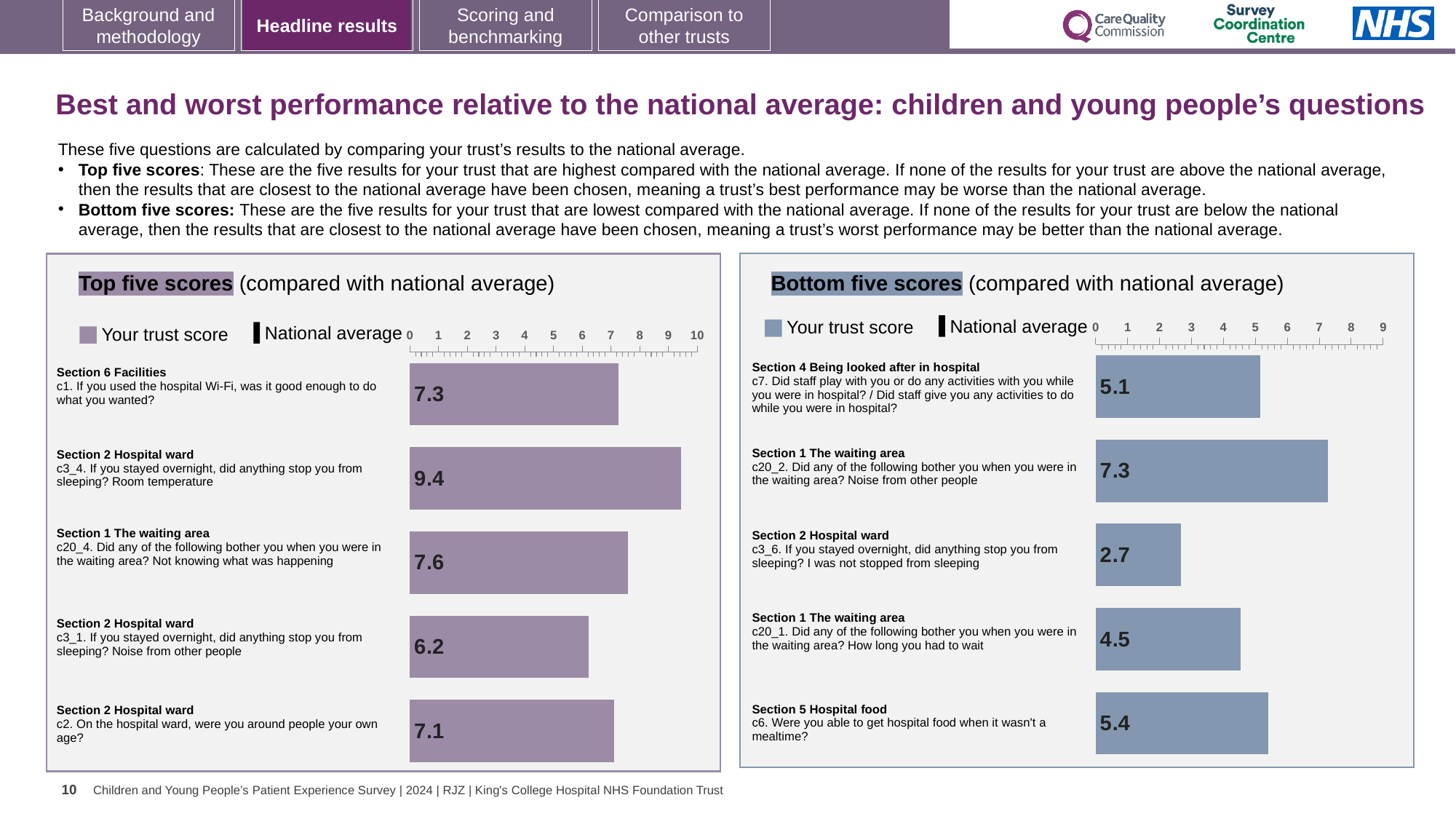
In the Top five scores chart, which question has the lowest trust score? c3_1 (Noise from other people) What type of chart is the Top five scores chart? Bar chart In the Bottom five scores chart, which question has the lowest trust score? c3_6 (I was not stopped from sleeping) In the Top five scores chart, what is the difference between the scores for c3_4 and c3_1? 3.2 In the Bottom five scores chart, what is the trust score for c6 (getting hospital food when it wasn't a mealtime)? 5.4 In the Top five scores chart, what is the trust score for c3_4 (room temperature stopping sleep)? 9.4 In the Bottom five scores chart, which question has the highest trust score? c20_2 (Noise from other people) In the Top five scores chart, what is the trust score for c1 (hospital Wi-Fi)? 7.3 How many bars are plotted in the Bottom five scores chart? 5 In the Bottom five scores chart, what is the trust score for c3_6 (I was not stopped from sleeping)? 2.7 In the Bottom five scores chart, which is larger: the score for c7 or the score for c20_1? c7 In the Top five scores chart, which question has the highest trust score? c3_4 (Room temperature)